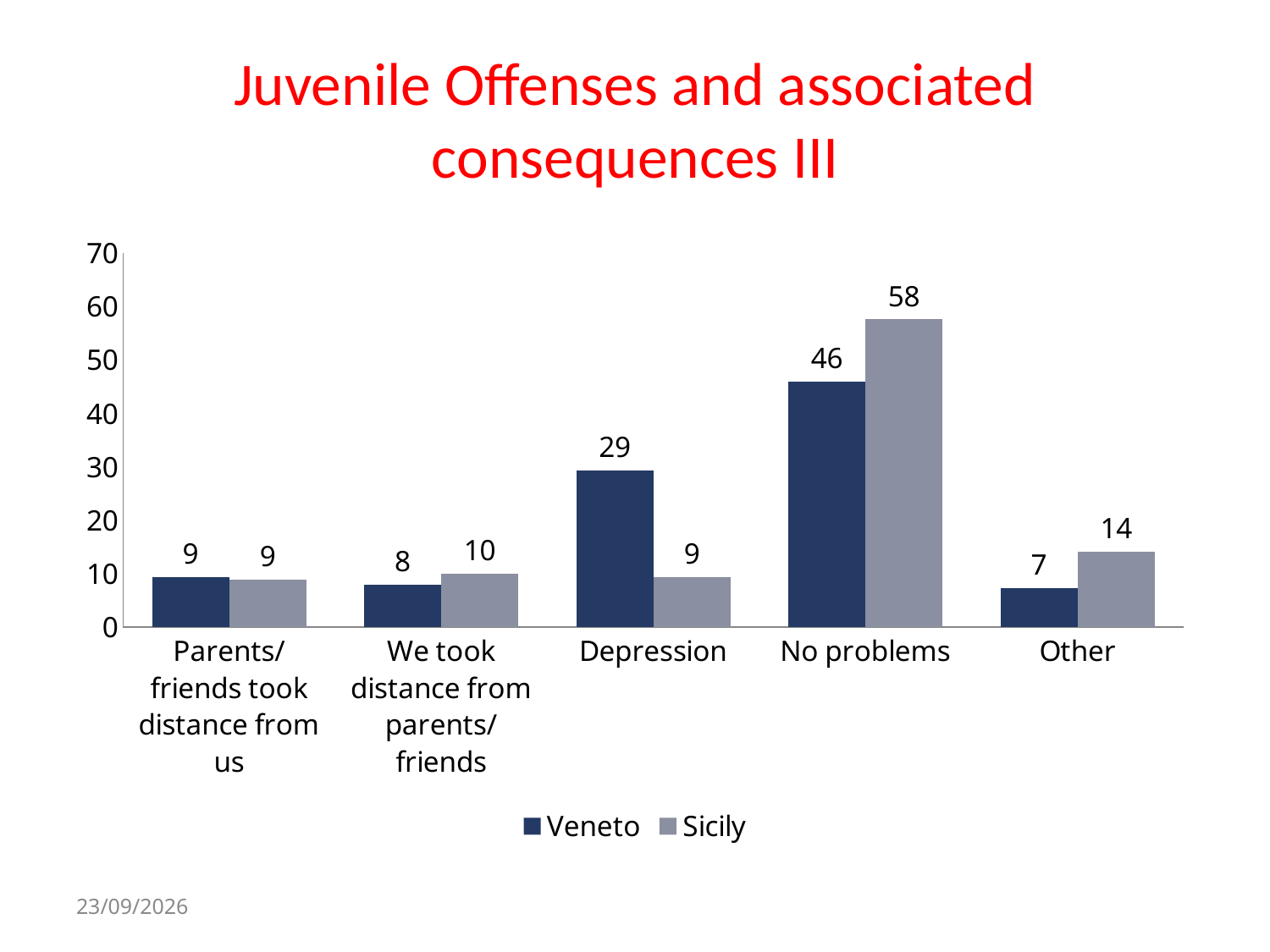
How many categories are shown on the x axis? 5 What is the difference between the Veneto and Sicily values for Depression? 20 Which category has the highest Sicily value? No problems What is the difference between the Sicily and Veneto values for No problems? 12 What is the Sicily value for Other? 14 Which is larger for Other: the Veneto value or the Sicily value? Sicily Which category has the lowest Veneto value? Other What is the Veneto value for 'We took distance from parents/friends'? 8 What is the Veneto value for Depression? 29 What kind of chart is shown on the slide? Bar chart What is the Sicily value for No problems? 58 How many series does the legend list? 2